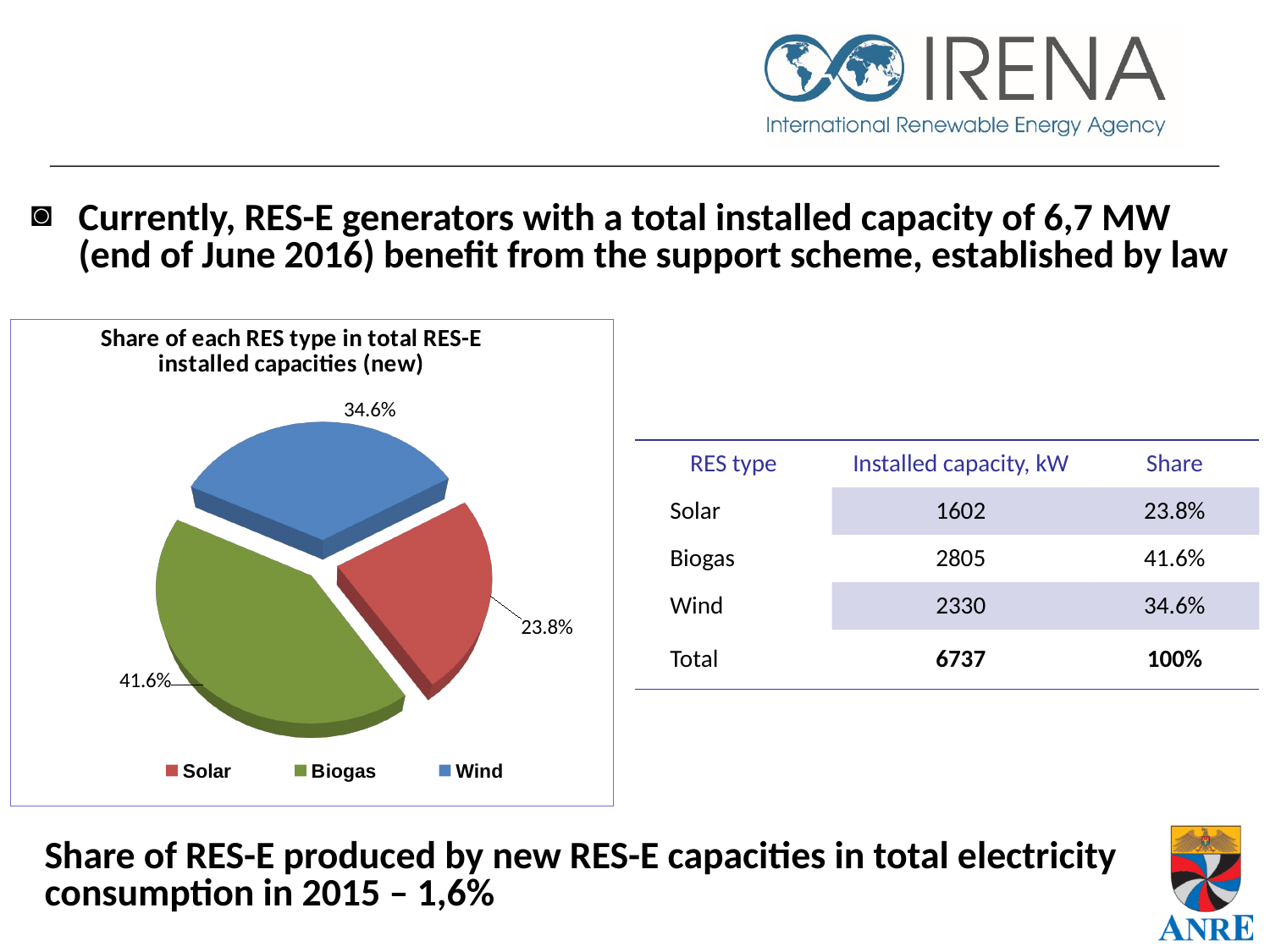
Which RES type has the smallest share in the pie chart? Solar Which RES type has the largest share in the pie chart? Biogas What type of chart is shown on the slide? Pie chart What is the title of the chart? Share of each RES type in total RES-E installed capacities (new) What share does the Solar slice have in the pie chart? 23.8% What share does the Biogas slice have in the pie chart? 41.6% What is the difference in percentage points between the Biogas and Solar shares in the pie chart? 17.8 percentage points Which has a larger share in the pie chart, Wind or Solar? Wind What share does the Wind slice have in the pie chart? 34.6% How many slices does the pie chart have? 3 What colour is the Biogas slice in the pie chart? Green How many entries does the legend of the pie chart list? 3